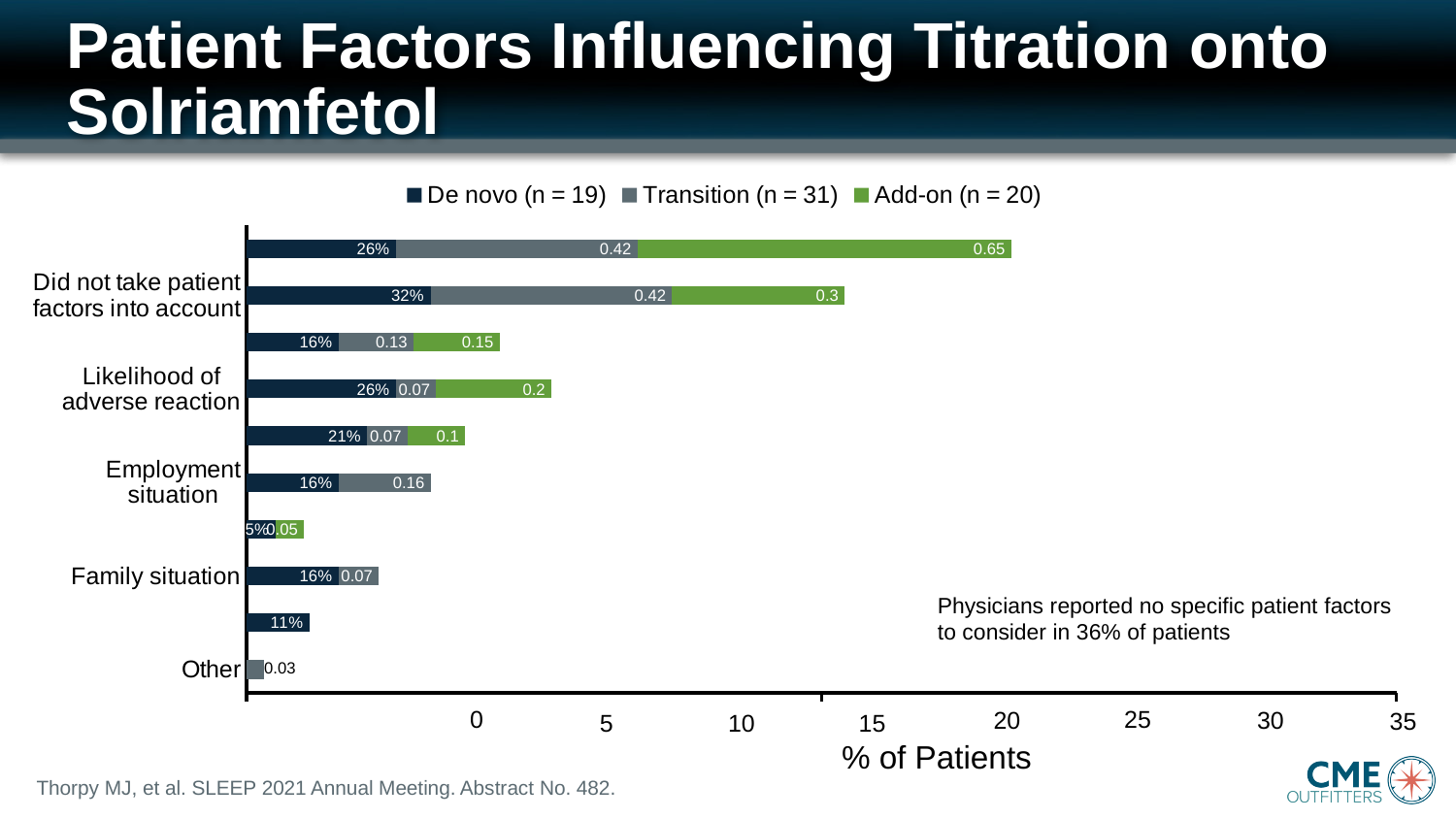
What is the largest De novo percentage labelled on the chart? 32% What is the Transition value shown for the 'Other' category? 0.03 What is the De novo value labelled on the second bar from the bottom? 11% What type of chart is shown on the slide? Stacked bar chart What is the x-axis title of the chart? % of Patients What are the three series named in the legend? De novo (n = 19), Transition (n = 31), Add-on (n = 20) What is the De novo value labelled on the topmost bar? 26% How many series does the legend list? 3 What is the Transition value labelled on the second bar from the top? 0.42 How many bars are plotted on the chart? 10 In the second bar from the top, which is larger: the Transition segment or the Add-on segment? Transition What is the largest Add-on data label shown on the chart? 0.65